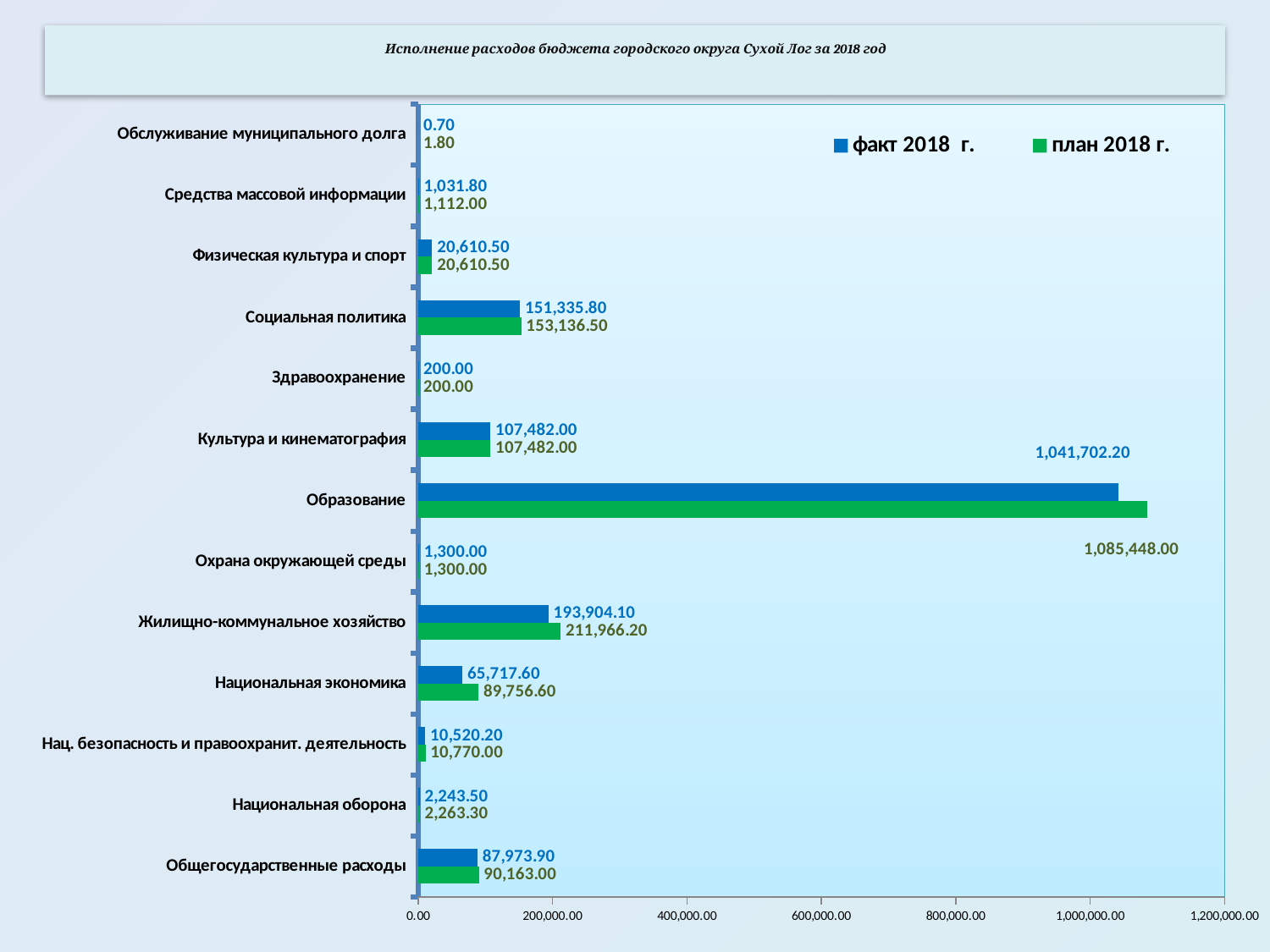
Which category has the lowest факт 2018 г. value? Обслуживание муниципального долга What is the план 2018 г. value for Жилищно-коммунальное хозяйство? 211,966.20 What is the difference between the план 2018 г. and факт 2018 г. values for Образование? 43,745.80 What is the difference between the план 2018 г. and факт 2018 г. values for Национальная экономика? 24,039.00 Which colour represents the факт 2018 г. series? blue How many series does the legend list? 2 What is the факт 2018 г. value for Национальная экономика? 65,717.60 What is the факт 2018 г. value for Образование? 1,041,702.20 Which is larger for Социальная политика: the факт 2018 г. value or the план 2018 г. value? план 2018 г. How many categories are shown on the chart? 13 What type of chart is shown on the slide? bar chart Which category has the highest план 2018 г. value? Образование